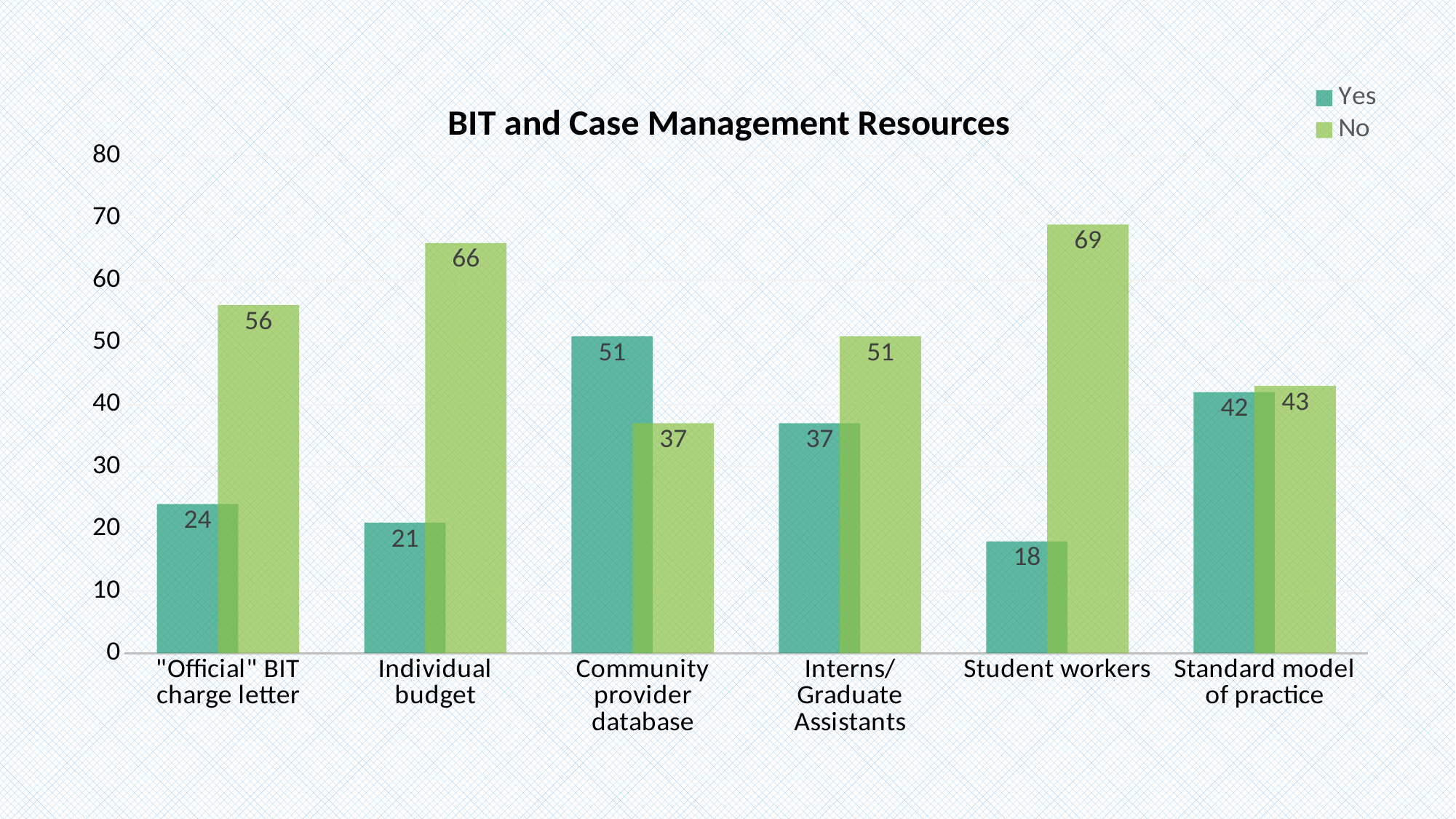
Which is larger for Interns/Graduate Assistants, the "Yes" value or the "No" value? No What is the "Yes" value for Community provider database? 51 What is the "No" value for Standard model of practice? 43 What kind of chart is shown? Bar chart What is the "No" value for Individual budget? 66 What is the title of the chart? BIT and Case Management Resources What is the difference between the "No" and "Yes" values for Student workers? 51 How many series does the legend list? 2 How many categories are shown on the x axis? 6 What is the "Yes" value for "Official" BIT charge letter? 24 Which category has the lowest "Yes" value? Student workers Which category has the highest "No" value? Student workers